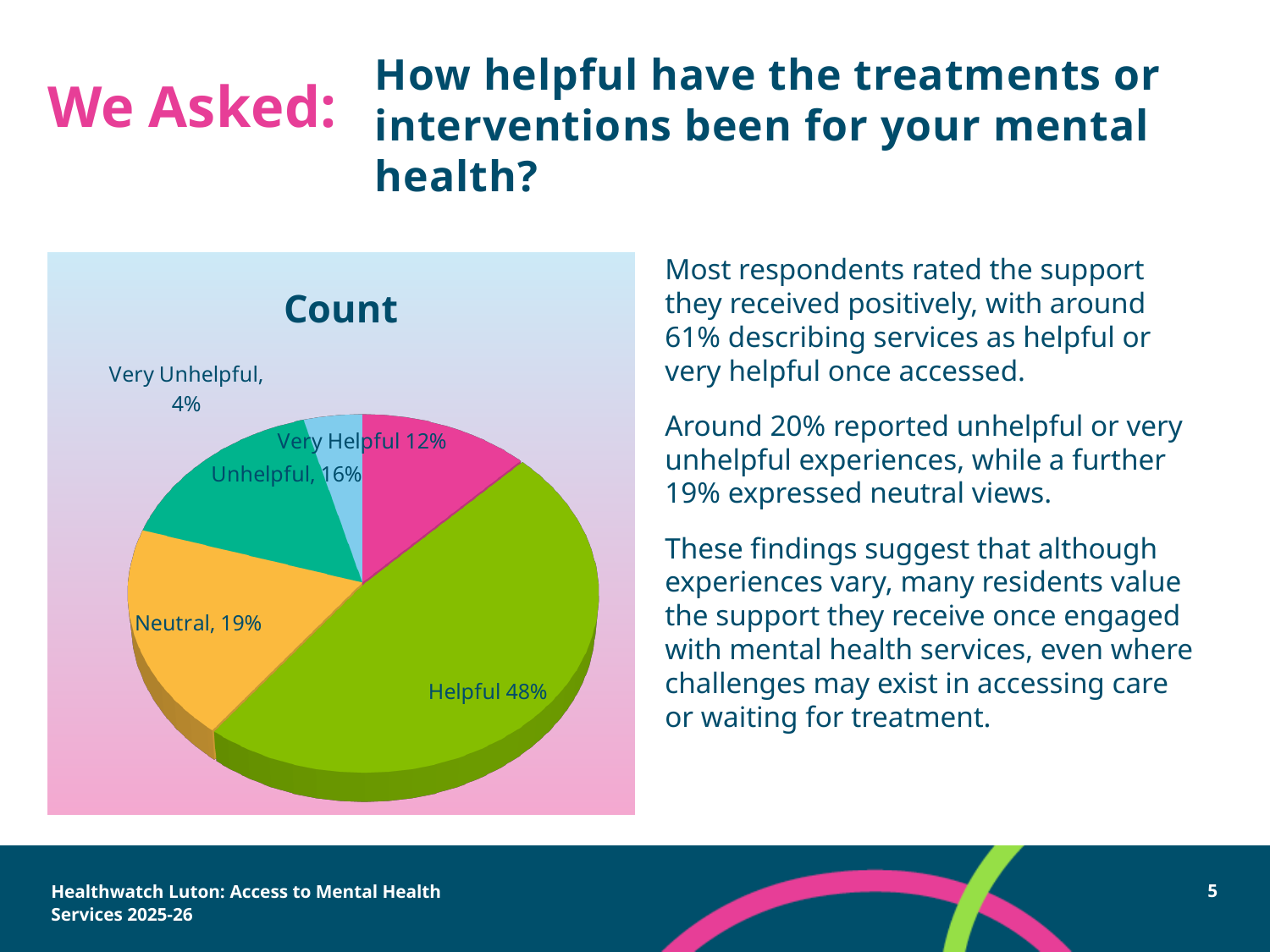
What percentage of respondents rated treatments as Very Unhelpful? 4% Which is larger, the share for Unhelpful or the share for Very Helpful? Unhelpful What percentage of respondents rated treatments as Very Helpful? 12% What percentage of respondents rated treatments as Unhelpful? 16% What is the difference in percentage points between Helpful and Neutral? 29 How many categories are shown in the pie chart? 5 Which category has the largest share of the pie? Helpful What kind of chart is shown on the slide? Pie chart What is the chart's title? Count What percentage of respondents gave a Neutral rating? 19% What percentage of respondents rated treatments as Helpful? 48% Which category has the smallest share of the pie? Very Unhelpful